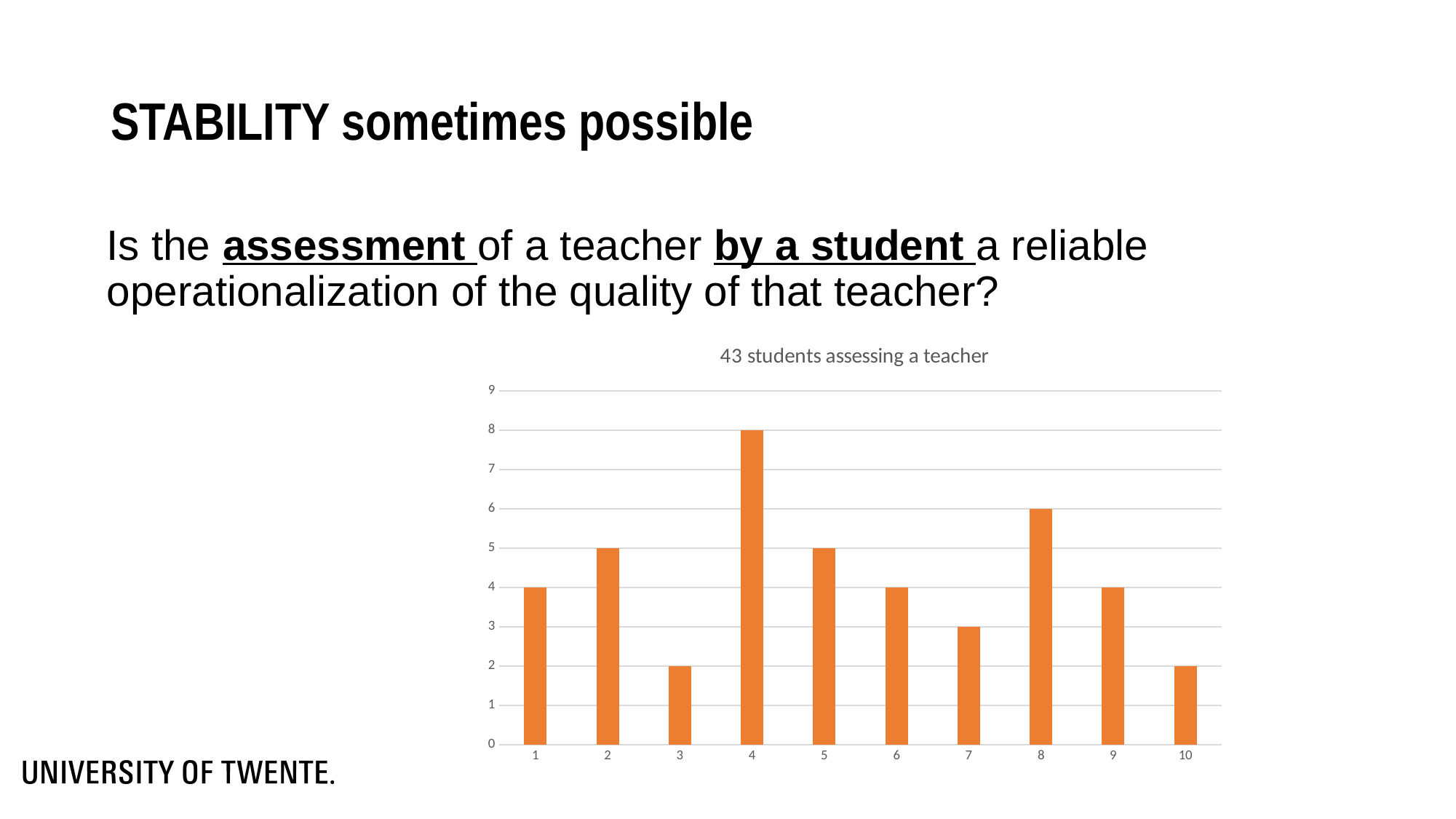
What colour are the bars in the chart? orange What is the value for category 8? 6 What is the value for category 4? 8 Which is larger, the value for category 2 or the value for category 3? category 2 What is the value for category 10? 2 What kind of chart is shown on the slide? bar chart Is the value for category 8 greater or less than 5? greater How many categories are shown on the x axis of the chart? 10 What is the difference between the values for category 4 and category 8? 2 What is the value for category 7? 3 What is the title of the chart? 43 students assessing a teacher Which category has the highest bar in the chart? 4